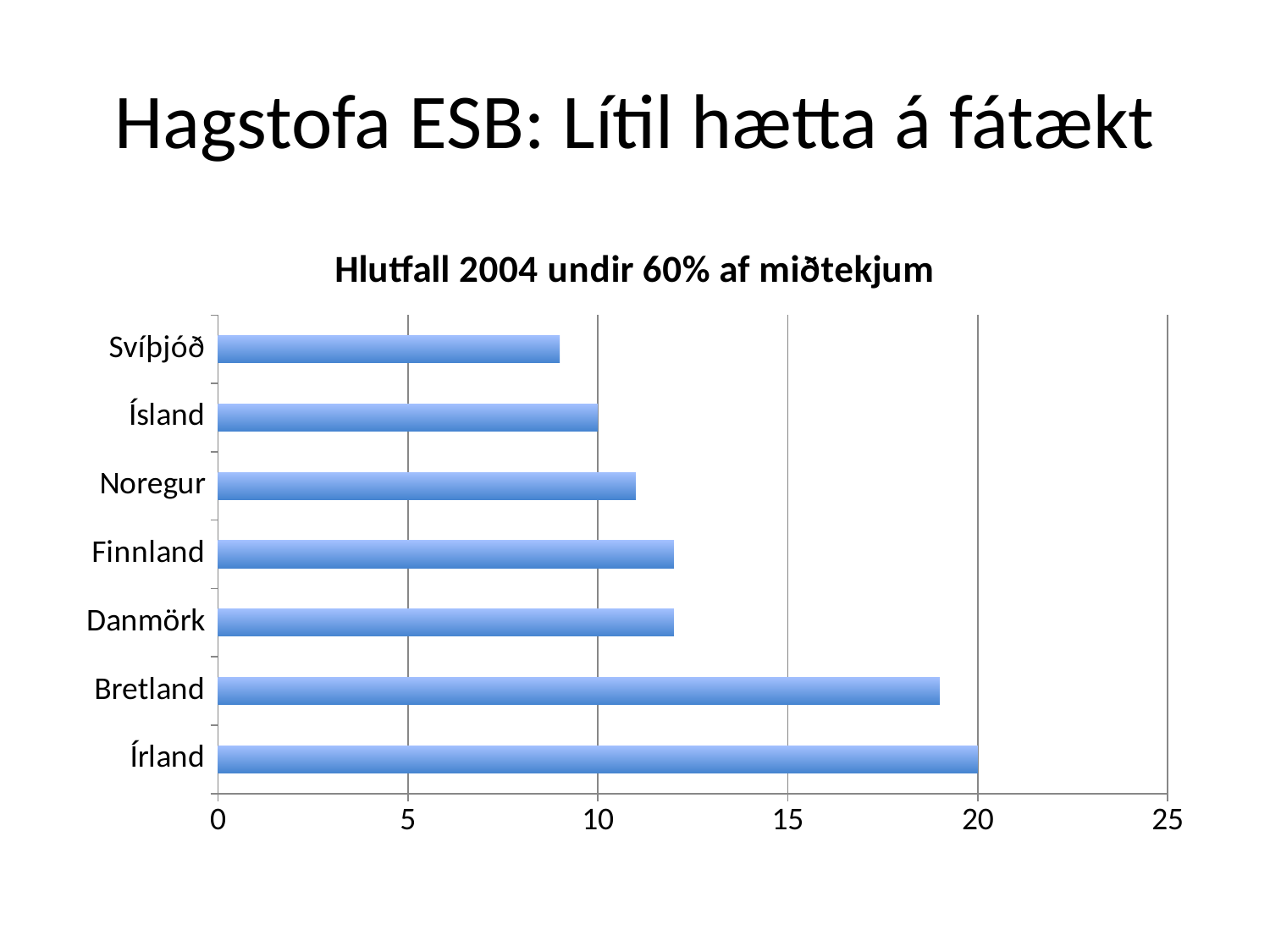
Which country has the lowest value in the chart? Svíþjóð Is the value for Svíþjóð greater or less than 10? less What is the title of the chart? Hlutfall 2004 undir 60% af miðtekjum What is the difference between the values for Írland and Ísland? 10 What is the value for Ísland? 10 Is the value for Noregur greater or less than 10? greater What kind of chart is shown on the slide? bar chart How many countries are shown in the chart? 7 Which has a larger value, Bretland or Finnland? Bretland Which country has the highest value in the chart? Írland What is the value for Írland? 20 Is the value for Bretland greater or less than 15? greater